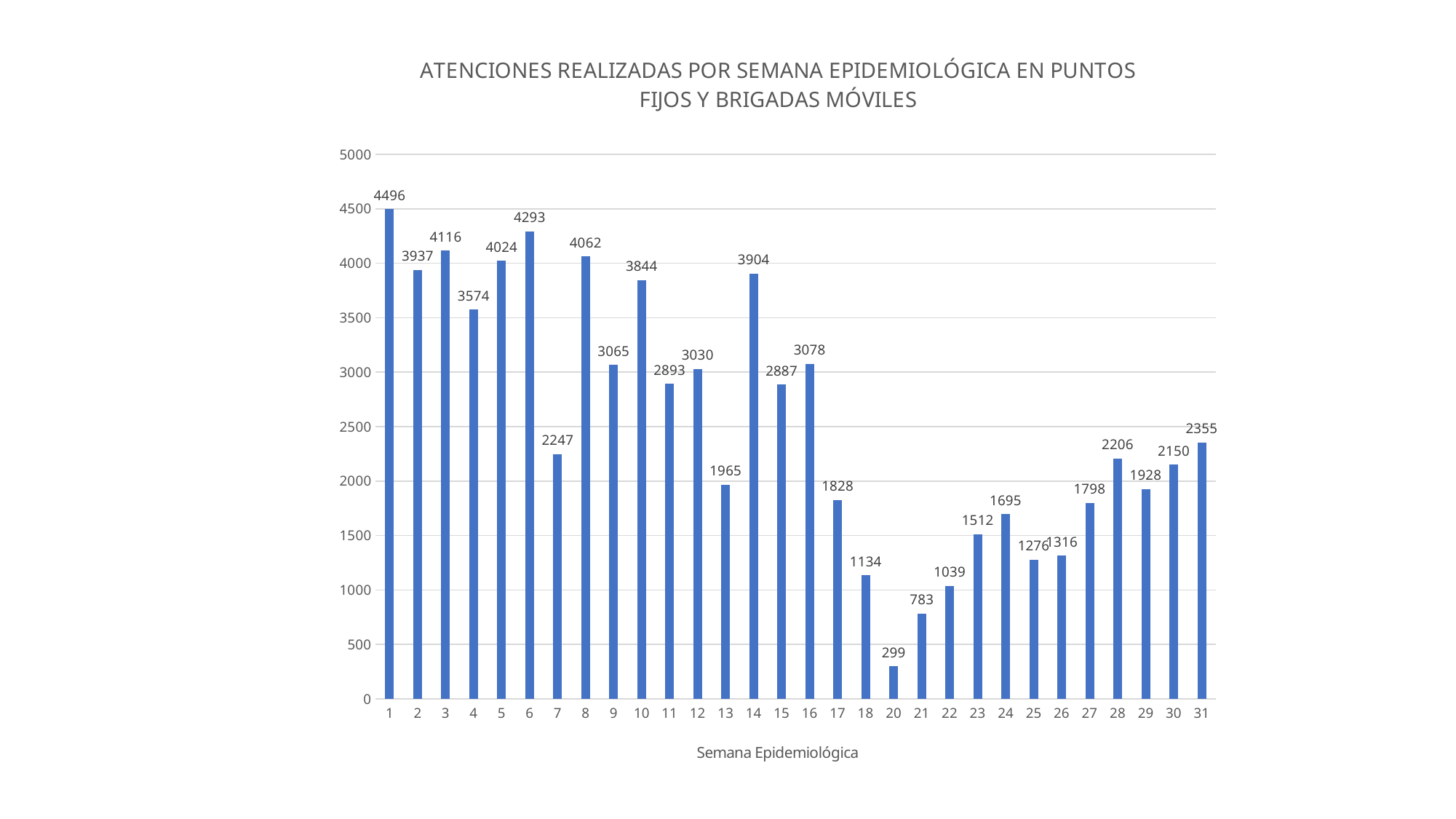
Do the values generally rise or fall from semana 20 to semana 31? rise What is the label of the x axis? Semana Epidemiológica What is the value for semana epidemiológica 1? 4496 What is the difference between the values for semana 1 and semana 20? 4197 Which semana epidemiológica has the highest number of atenciones? 1 How many semanas epidemiológicas are plotted on the chart? 30 What is the difference between the values for semana 6 and semana 8? 231 What is the value for semana epidemiológica 20? 299 What is the value for semana epidemiológica 14? 3904 Which semana epidemiológica has the lowest number of atenciones? 20 What type of chart is shown on the slide? bar chart Which has a larger value, semana 7 or semana 13? semana 7